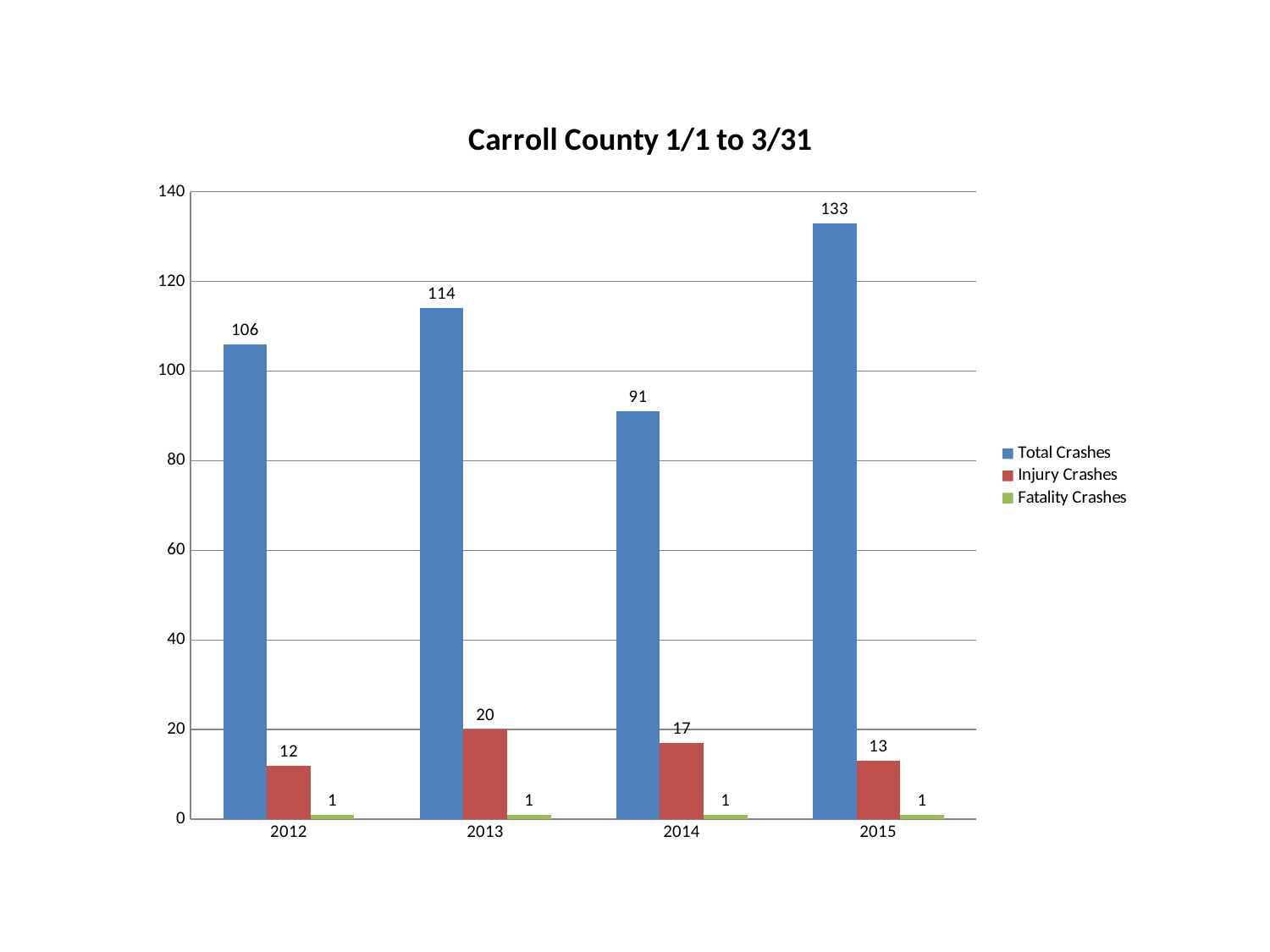
Is the value for Total Crashes in 2013 greater or less than 100? greater How many years are shown on the x axis? 4 What is the difference between Total Crashes in 2015 and 2014? 42 What kind of chart is shown? bar chart Which year has the highest Total Crashes? 2015 Which is larger, Injury Crashes in 2012 or Injury Crashes in 2015? 2015 How many series does the legend list? 3 What is the value for Fatality Crashes in 2014? 1 Which year has the lowest Total Crashes? 2014 What is the value for Injury Crashes in 2013? 20 What is the value for Total Crashes in 2015? 133 What is the title of the chart? Carroll County 1/1 to 3/31